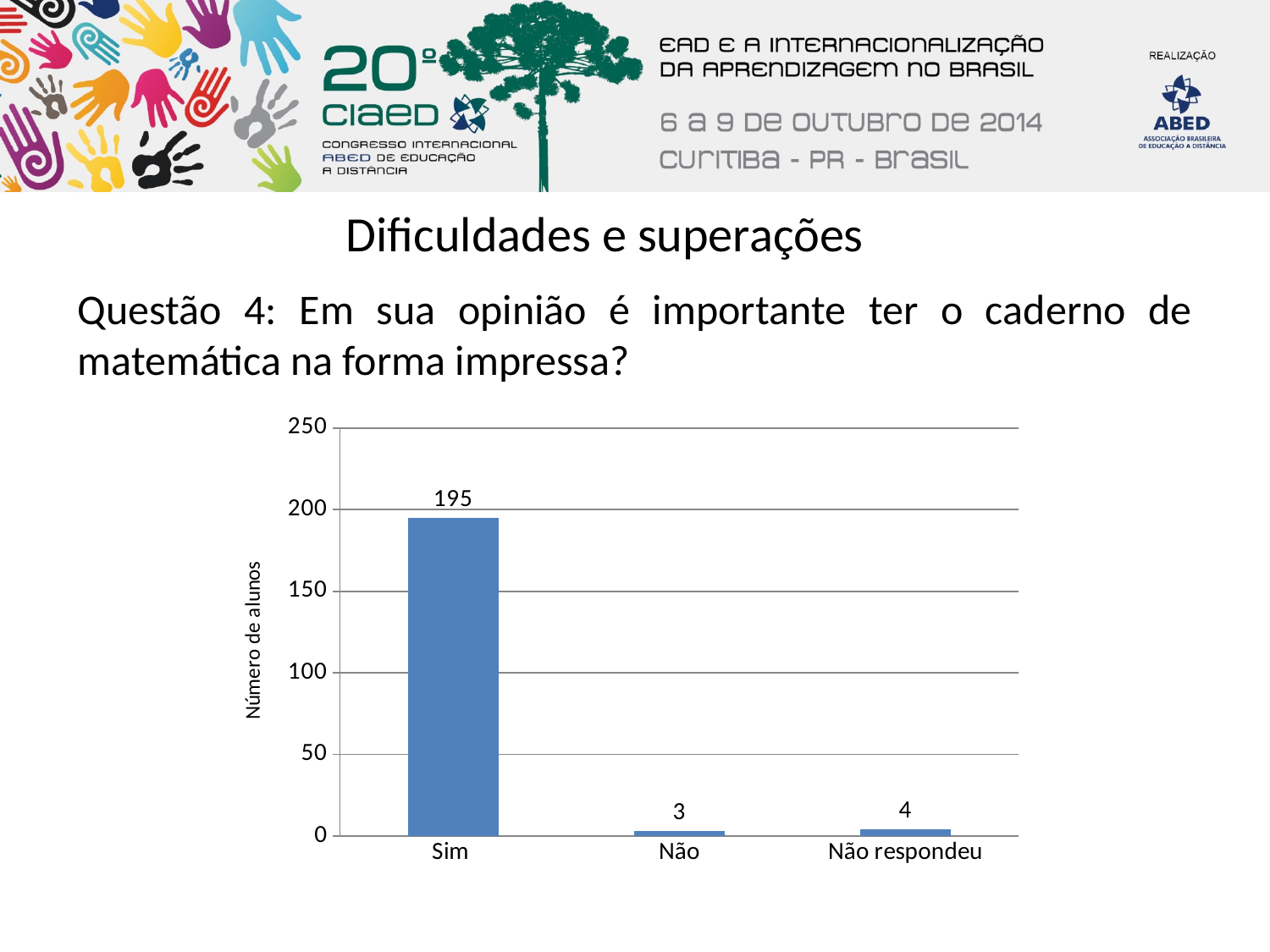
Is the value for Sim greater or less than 150? greater What is the value for Não respondeu? 4 Which category has the lowest value? Não What is the difference between the values for Sim and Não respondeu? 191 Which category has the highest value? Sim What is the value for Não? 3 What kind of chart is shown? bar chart What is the value for Sim? 195 What is the total of the three values shown? 202 Which is larger, the value for Não or the value for Não respondeu? Não respondeu How many categories are shown on the x axis? 3 What is the label of the vertical axis? Número de alunos